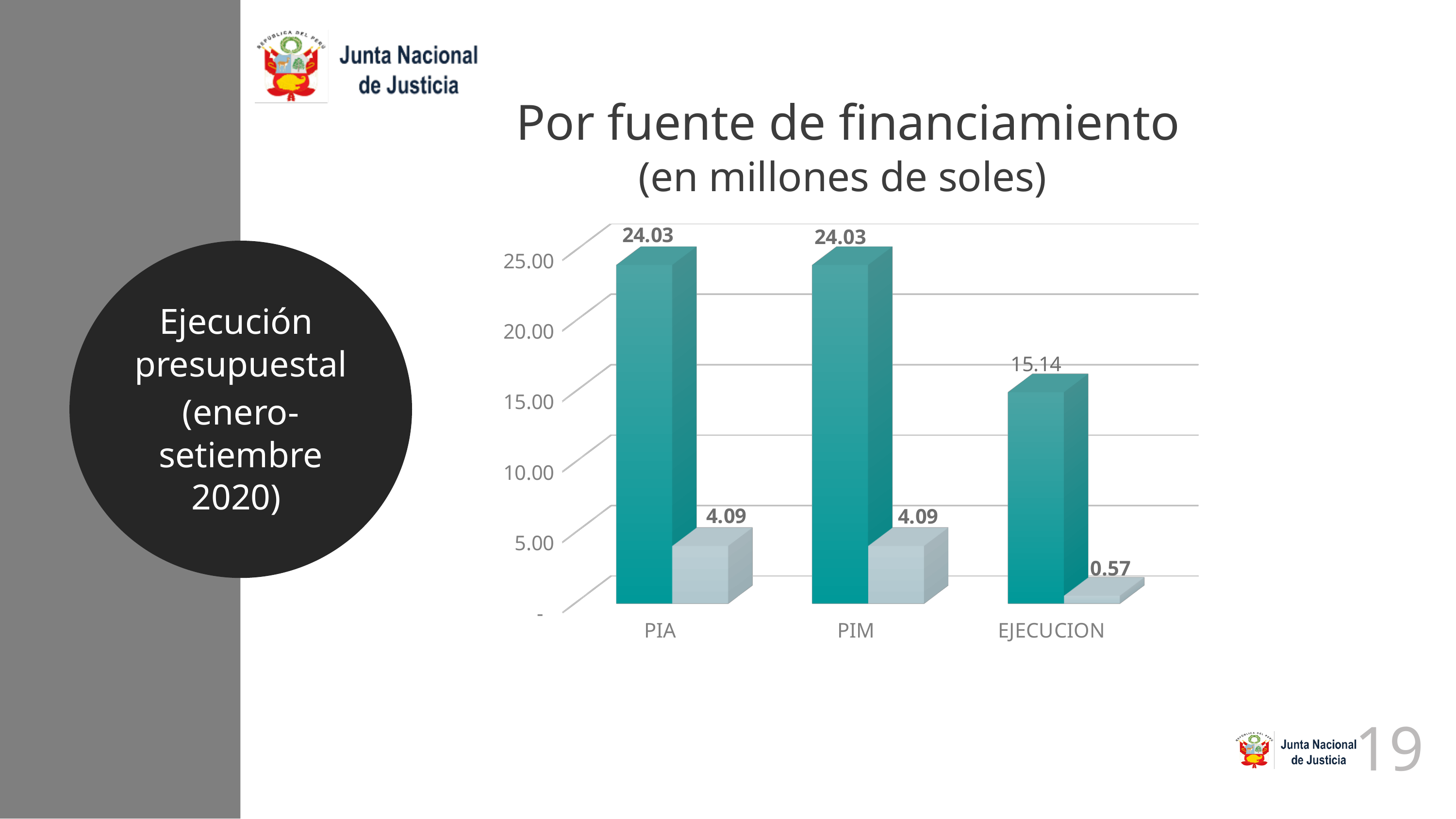
What is the title of the chart? Por fuente de financiamiento (en millones de soles) What is the value of the light grey bar for EJECUCION? 0.57 How many categories are shown on the x axis? 3 Which category has the lowest teal bar? EJECUCION What is the value of the teal bar for EJECUCION? 15.14 What kind of chart is shown on the slide? Bar chart What is the value of the light grey bar for PIA? 4.09 What is the value of the teal bar for PIM? 24.03 Which is larger: the teal bar for EJECUCION or the light grey bar for PIA? The teal bar for EJECUCION What is the difference between the teal bar for PIM and the teal bar for EJECUCION? 8.89 Which category has the lowest light grey bar? EJECUCION What is the difference between the light grey bar for PIM and the light grey bar for EJECUCION? 3.52